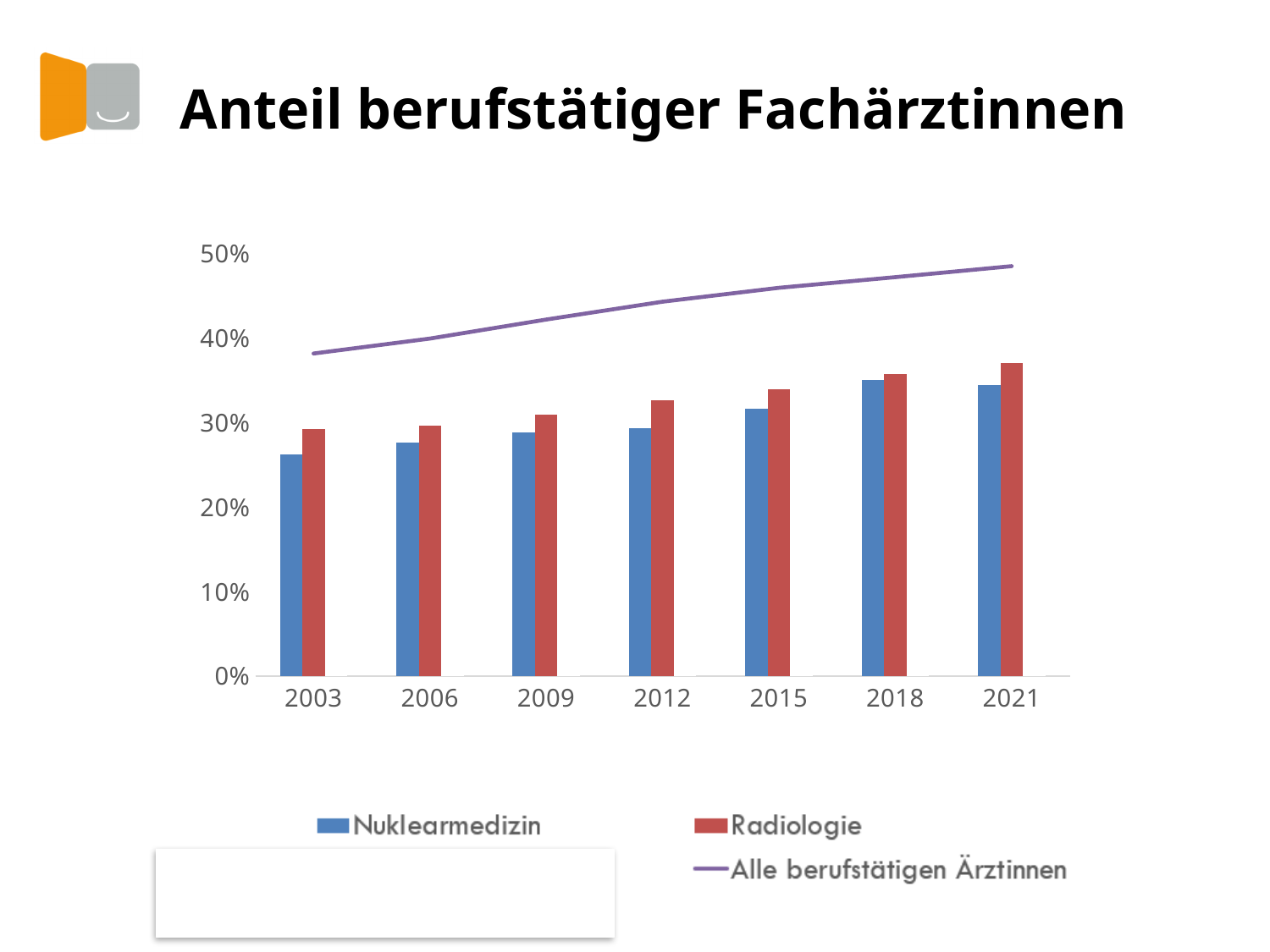
What is the title of the chart on the slide? Anteil berufstätiger Fachärztinnen Is the value for Nuklearmedizin in 2003 greater or less than 30%? less Does the line for Alle berufstätigen Ärztinnen rise or fall from 2003 to 2021? rise What kind of chart is shown on the slide? combination bar and line chart How many years are shown on the x axis of the chart? 7 In which year is the value for Nuklearmedizin lowest? 2003 Is the value for Alle berufstätigen Ärztinnen in 2021 greater or less than 40%? greater In which year is the value for Radiologie highest? 2021 How many series does the chart's legend list? 3 Is the value for Alle berufstätigen Ärztinnen in 2003 greater or less than 40%? less In 2012, which is larger: Nuklearmedizin or Radiologie? Radiologie